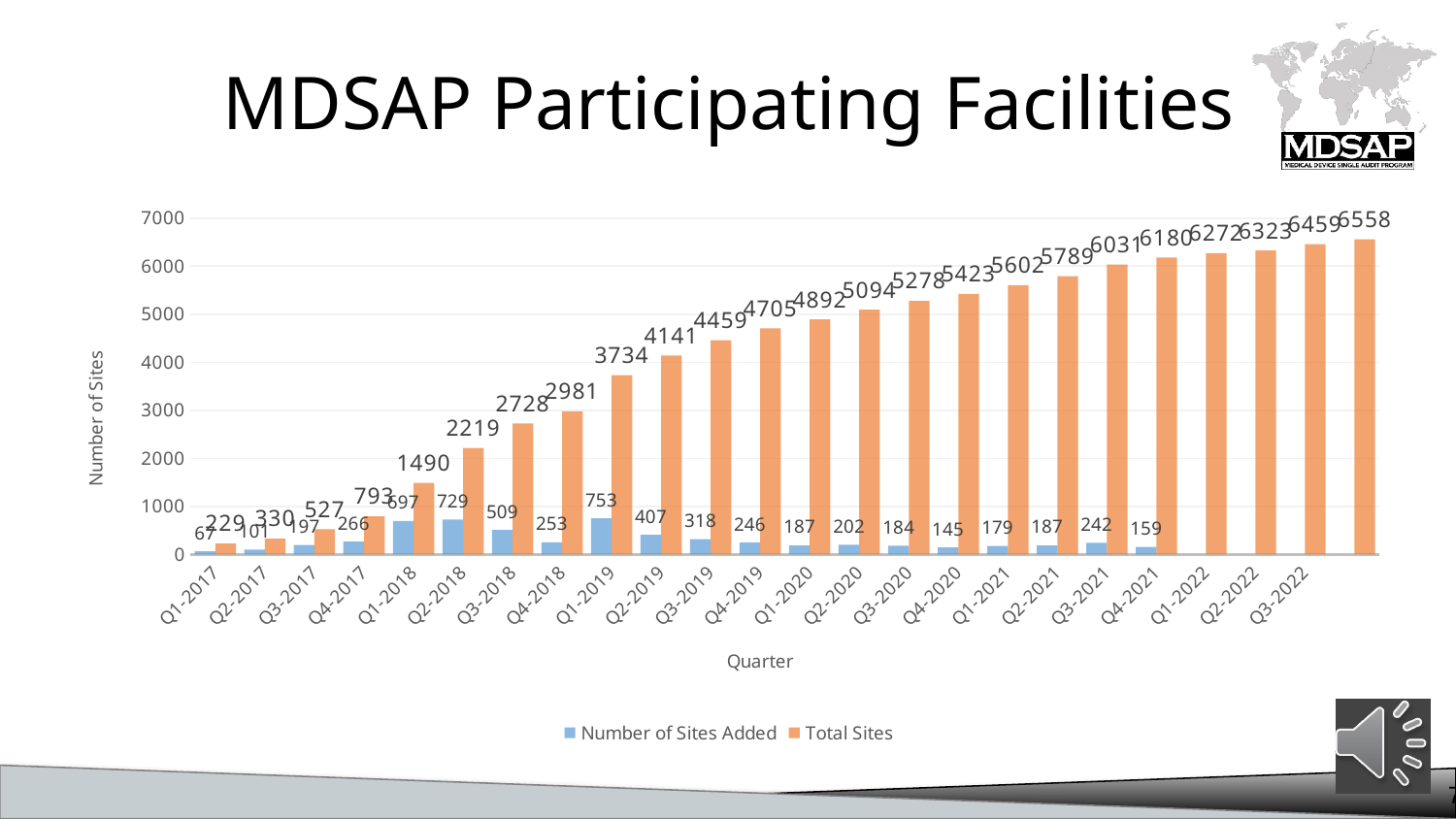
What is the highest Total Sites value shown on the chart? 6558 What is the Total Sites value for Q4-2017? 793 What is the Total Sites value for Q1-2018? 1490 Which quarter has the highest Number of Sites Added? Q1-2019 What kind of chart is shown on the slide? Bar chart Which quarter has the lowest Number of Sites Added? Q1-2017 What is the title of the vertical axis? Number of Sites Which quarter had more sites added, Q1-2018 or Q2-2018? Q2-2018 What is the Number of Sites Added in Q1-2019? 753 How many series does the legend list? 2 What is the difference between Total Sites in Q2-2018 and Q1-2018? 729 Do the Total Sites values rise or fall across the quarters? Rise